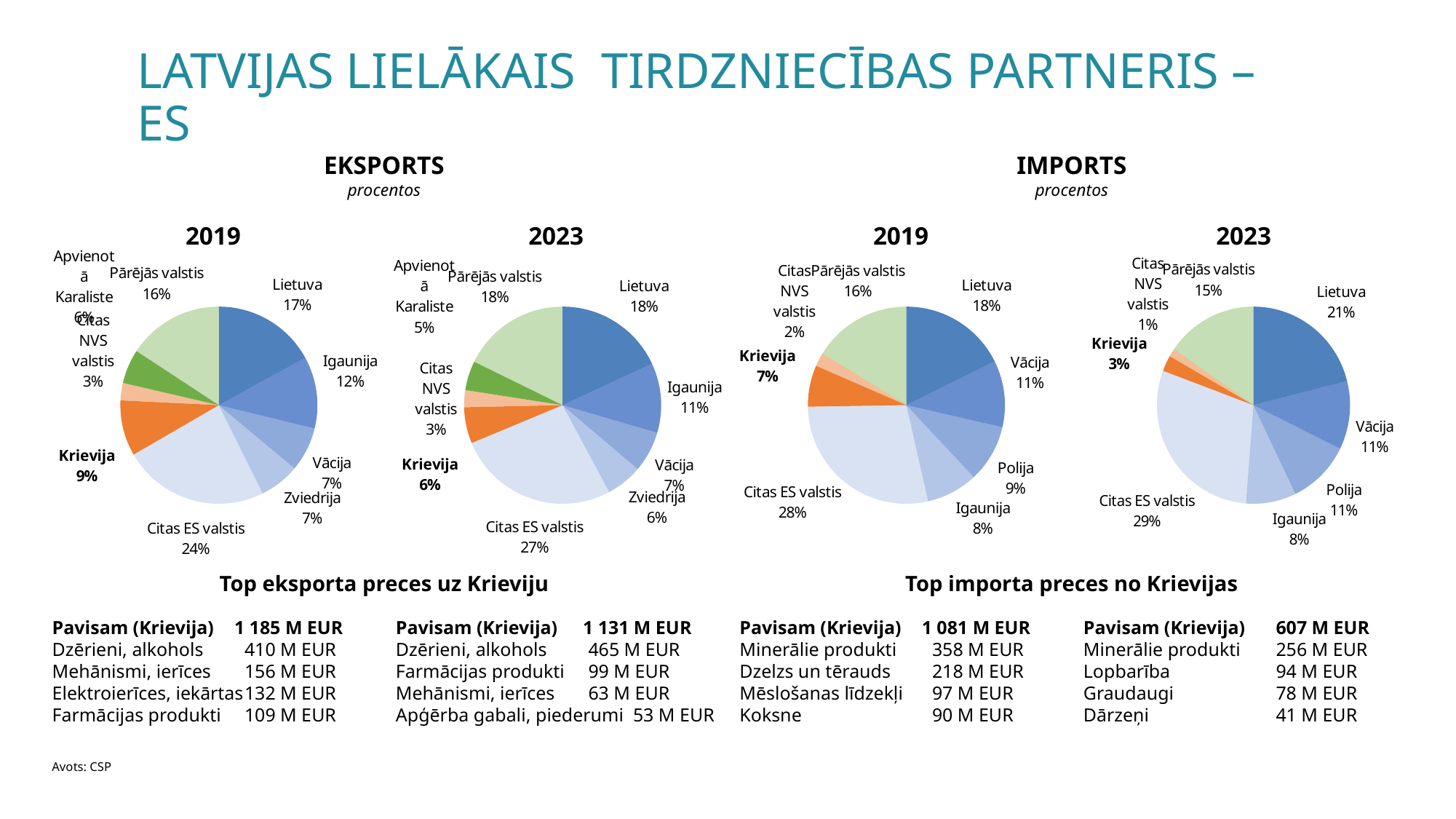
In the Eksports 2023 pie chart, what share does Citas ES valstis have? 27% What type of chart is used for the Eksports 2019 data? Pie chart In the Eksports 2019 pie chart, what share does Krievija have? 9% What is the difference between the Krievija share in the Imports 2019 pie chart and the Krievija share in the Imports 2023 pie chart? 4 percentage points In the Imports 2023 pie chart, what share does Lietuva have? 21% In the Imports 2019 pie chart, what share does Polija have? 9% In the Eksports 2023 pie chart, which is larger: the share of Lietuva or the share of Igaunija? Lietuva In the Eksports 2019 pie chart, which category has the smallest share? Citas NVS valstis How many slices does the Imports 2019 pie chart have? 8 In the Imports 2023 pie chart, which category has the largest share? Citas ES valstis What is the subtitle shown under both the EKSPORTS and IMPORTS headings? procentos In the Imports 2023 pie chart, which category has the smallest share? Citas NVS valstis